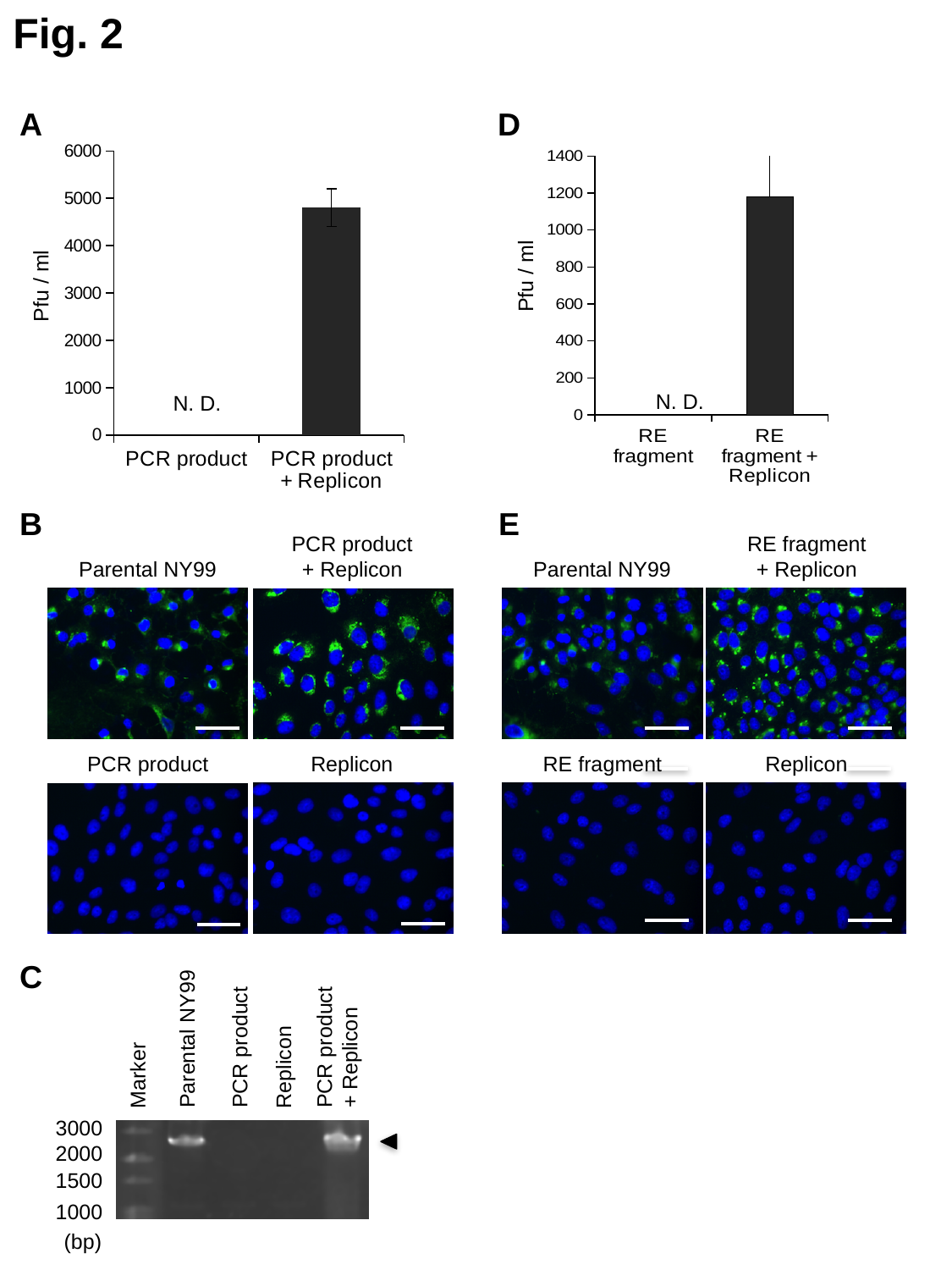
In panel D, what is shown for the RE fragment category? N. D. In panel A, is the value for PCR product + Replicon greater or less than 4000 Pfu / ml? greater What type of chart is panel D? bar chart In panel A, what is the y-axis label? Pfu / ml In panel A, is the value for PCR product + Replicon greater or less than 5000 Pfu / ml? less In panel A, what is shown for the PCR product category? N. D. What type of chart is panel A? bar chart In panel D, is the value for RE fragment + Replicon greater or less than 1400 Pfu / ml? less In panel D, which category has the higher value, RE fragment or RE fragment + Replicon? RE fragment + Replicon In panel A, what is the maximum value shown on the y axis? 6000 In panel A, how many categories are shown on the x axis? 2